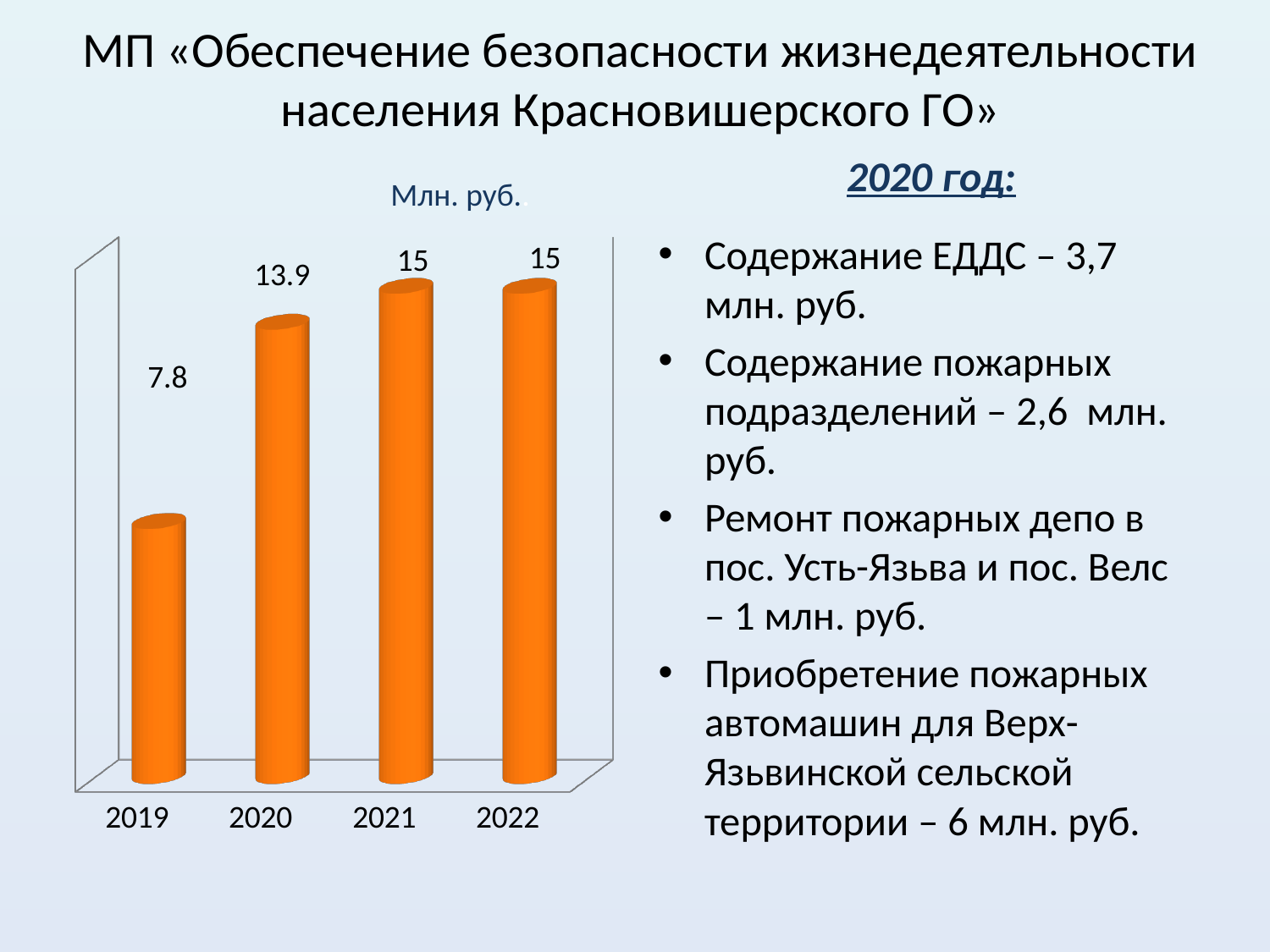
What is the value for 2020? 13.9 Which year has the lowest value? 2019 How many years are shown on the x axis? 4 What is the value for 2021? 15 Which is larger, the value for 2020 or the value for 2019? 2020 What colour are the bars in the chart? orange What is the difference between the values for 2020 and 2019? 6.1 What is the difference between the values for 2021 and 2020? 1.1 What kind of chart is shown on the slide? bar chart What is the title of the chart? Млн. руб. Do the values rise or fall from 2019 to 2021? rise What is the value for 2019? 7.8